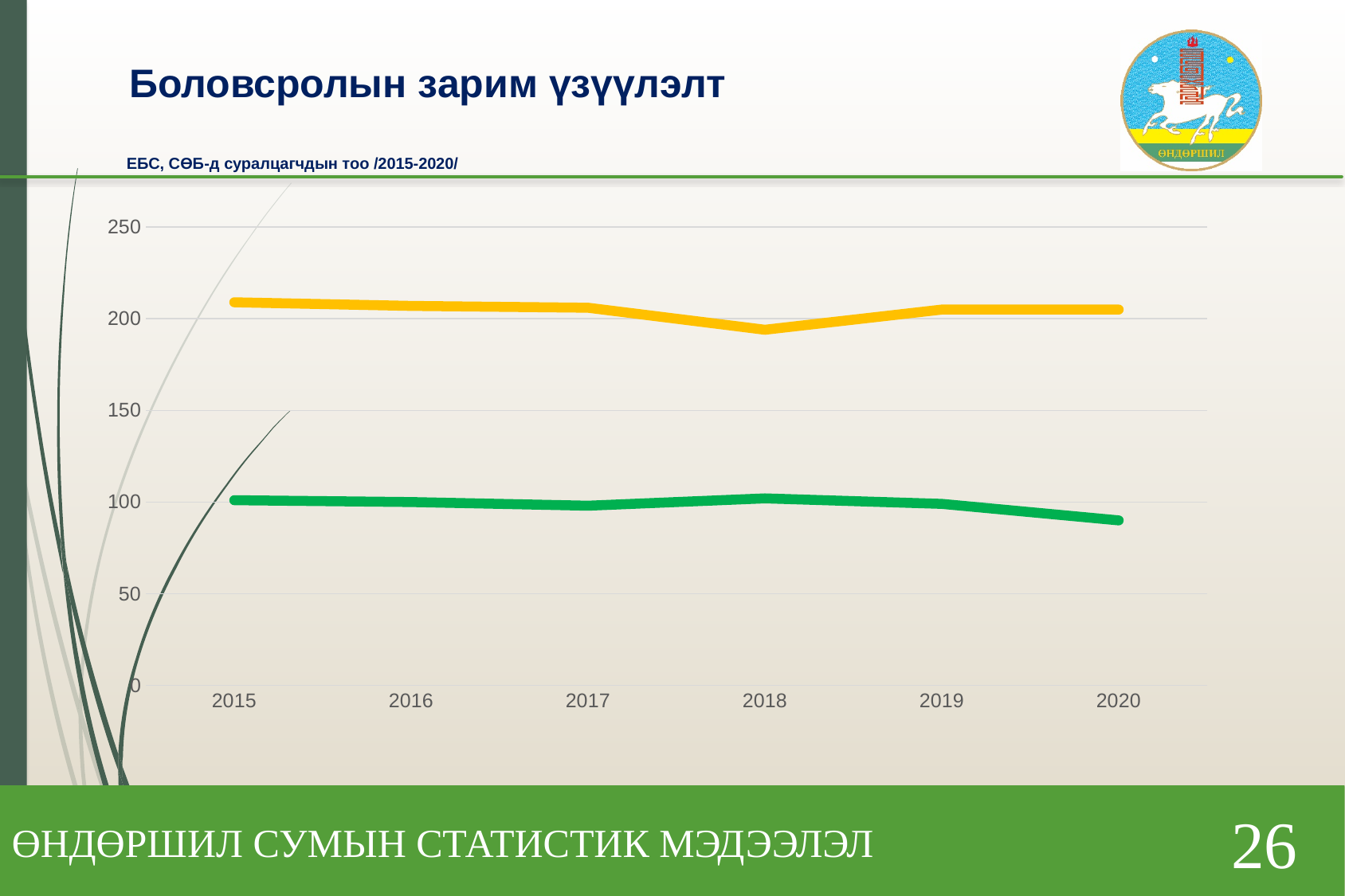
How many years are plotted along the x axis of the chart? 6 Does the yellow line rise or fall from 2017 to 2018? fall Is the value of the green line for 2015 greater or less than 150? less Is the value of the yellow line for 2015 greater or less than 200? greater Is the value of the green line for 2020 greater or less than 100? less What kind of chart is shown on the slide? line chart How many lines are plotted on the chart? 2 Does the green line rise or fall from 2019 to 2020? fall In 2020, which line has the larger value, the yellow line or the green line? the yellow line What is the title of the chart? ЕБС, СӨБ-д суралцагчдын тоо /2015-2020/